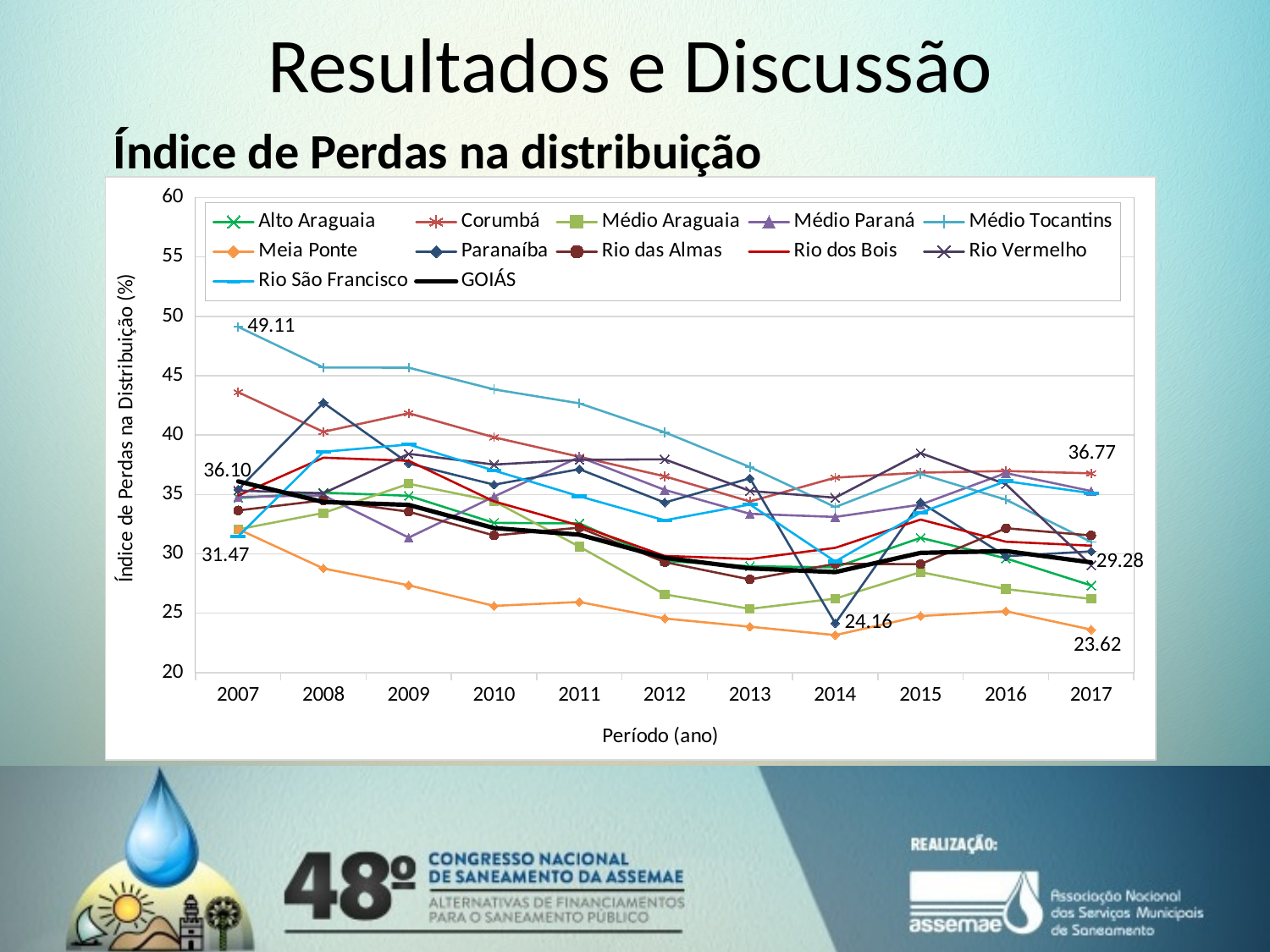
Is the value for Meia Ponte in 2014 greater or less than 25? less Which series has the highest value in 2007? Médio Tocantins What is the value for GOIÁS in 2007? 36.10 How many series does the legend list? 12 What is the value for Meia Ponte in 2017? 23.62 What is the value for Médio Tocantins in 2007? 49.11 What is the title of the x axis? Período (ano) How many years are plotted along the x axis? 11 What type of chart is shown on the slide? line chart What is the difference between the Médio Tocantins value in 2007 and the Meia Ponte value in 2017? 25.49 Which series has the lowest value in 2017? Meia Ponte Does the Médio Tocantins line rise or fall from 2007 to 2017? fall